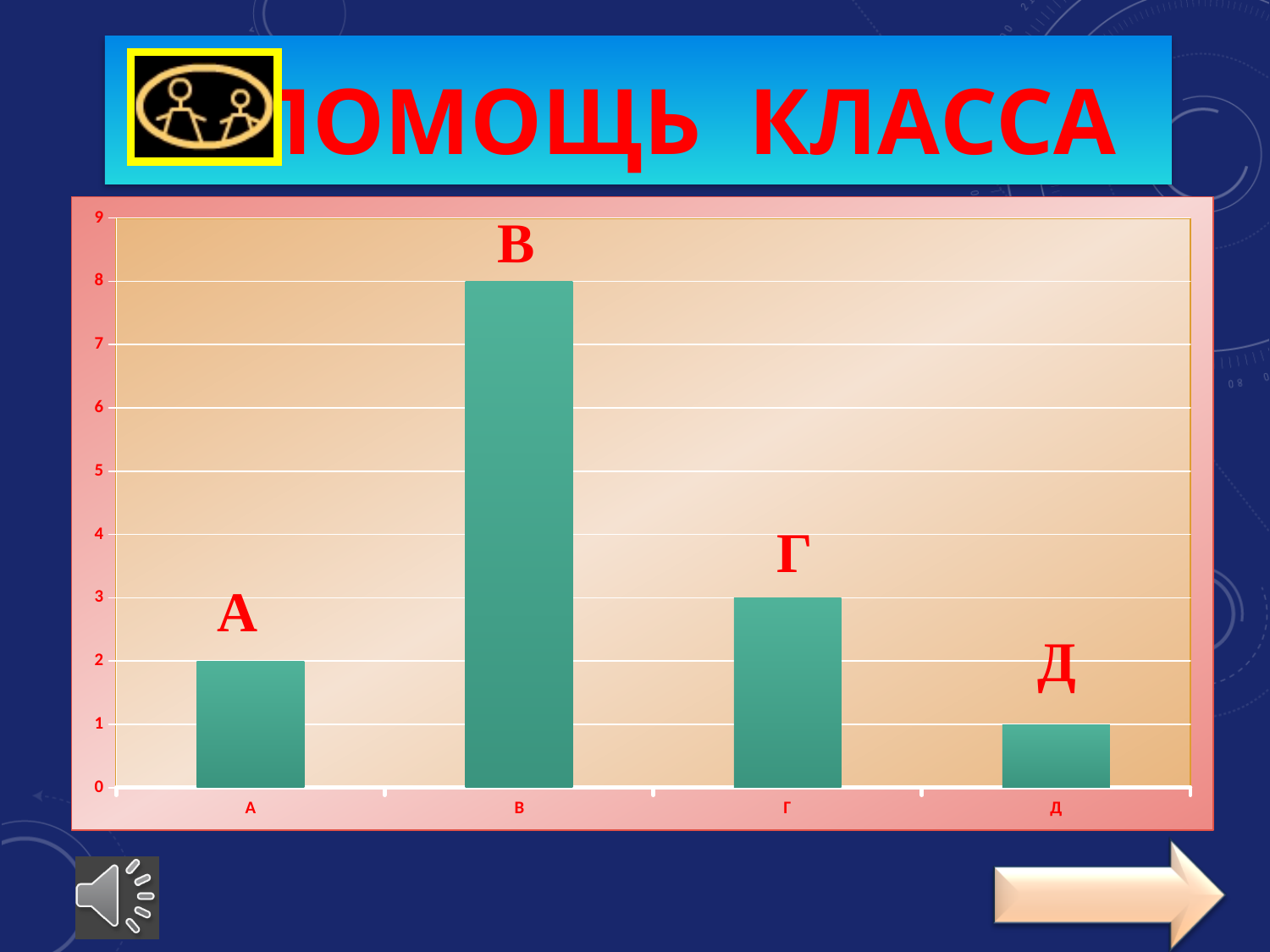
Which is larger, the value for А or the value for Г? Г Is the value for В greater or less than 5? greater What is the value for category А? 2 How many categories are shown on the x axis of the chart? 4 What is the maximum value shown on the vertical axis? 9 What is the value for category Г? 3 Which category has the lowest value? Д Which category has the highest value? В What is the value for category В? 8 What type of chart is shown on the slide? bar chart What is the difference between the values for В and Г? 5 What is the value for category Д? 1